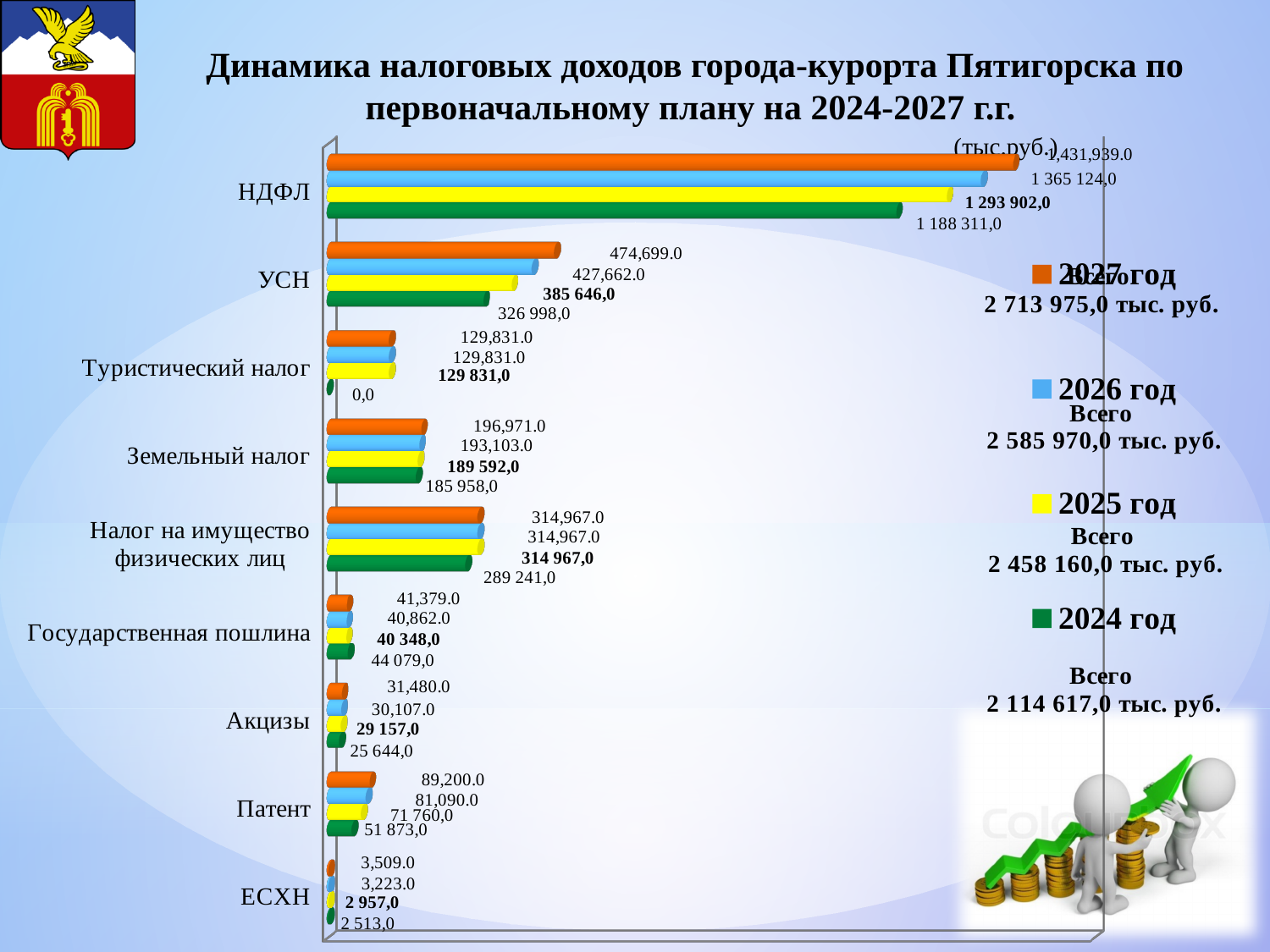
What is the value for Патент in 2027 год? 89,200.0 What is the difference between the 2027 год and 2026 год values for Патент? 8,110.0 Which category has the lowest value in 2027 год? ЕСХН How many series does the legend list? 4 What is the difference between the 2025 год and 2024 год values for Акцизы? 3 513,0 What is the value for НДФЛ in 2026 год? 1 365 124,0 How many tax categories are shown on the chart? 9 What is the value for УСН in 2024 год? 326 998,0 What is the value for Туристический налог in 2024 год? 0,0 For Государственная пошлина, which year has the larger value: 2024 год or 2027 год? 2024 год Which category has the highest value in 2024 год? НДФЛ What kind of chart is shown on the slide? bar chart